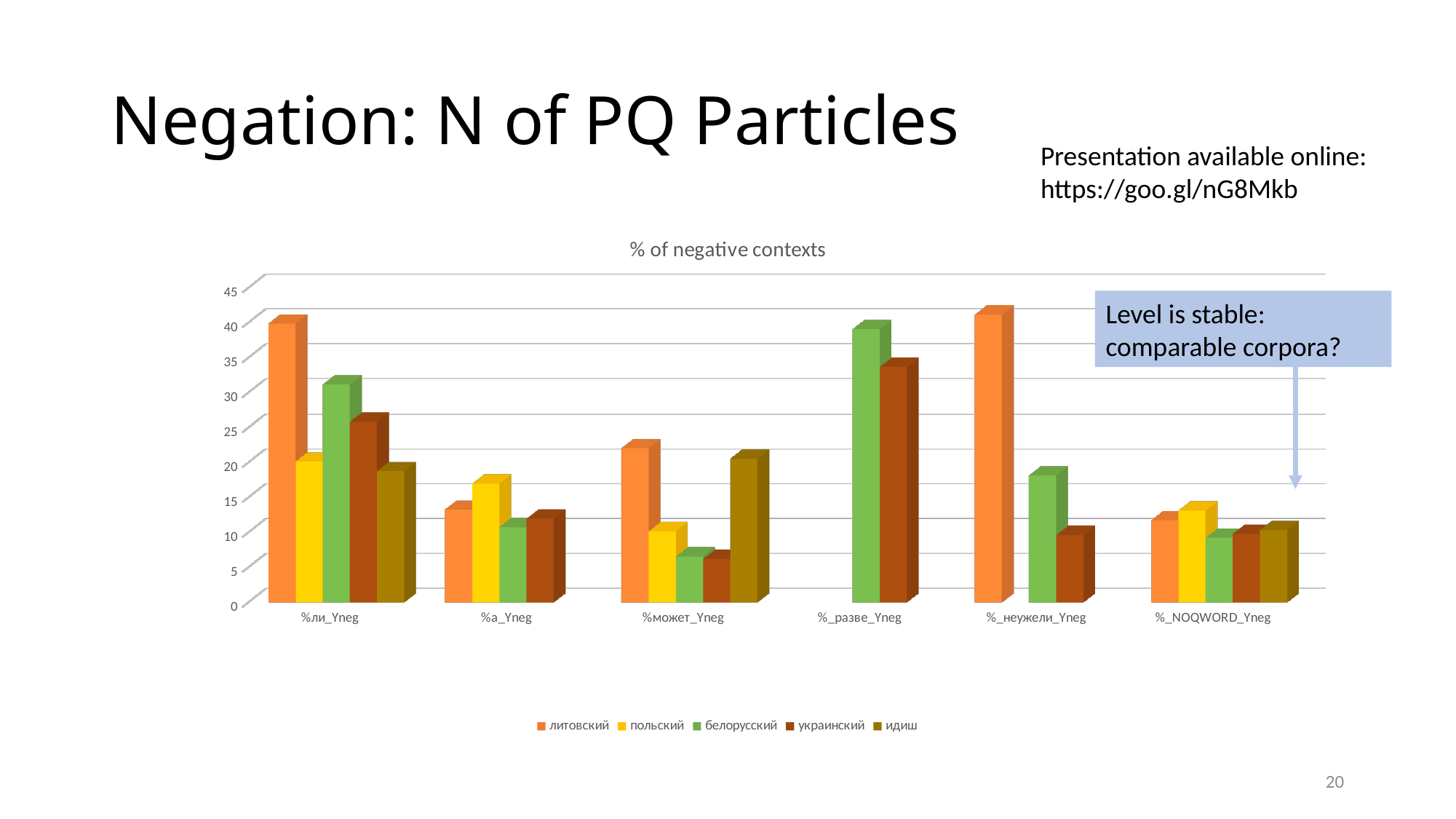
What kind of chart is shown on the slide? bar chart Is the value for белорусский in %_разве_Yneg greater or less than 35? greater Is the value for литовский in %ли_Yneg greater or less than 35? greater Which series has the highest value in the %ли_Yneg category? литовский Which series has the lowest value in the %_неужели_Yneg category? украинский Is the value for польский in %может_Yneg greater or less than 15? less How many categories are shown on the x axis? 6 How many series does the legend list? 5 What is the title of the chart? % of negative contexts In the %а_Yneg category, which is larger: польский or белорусский? польский